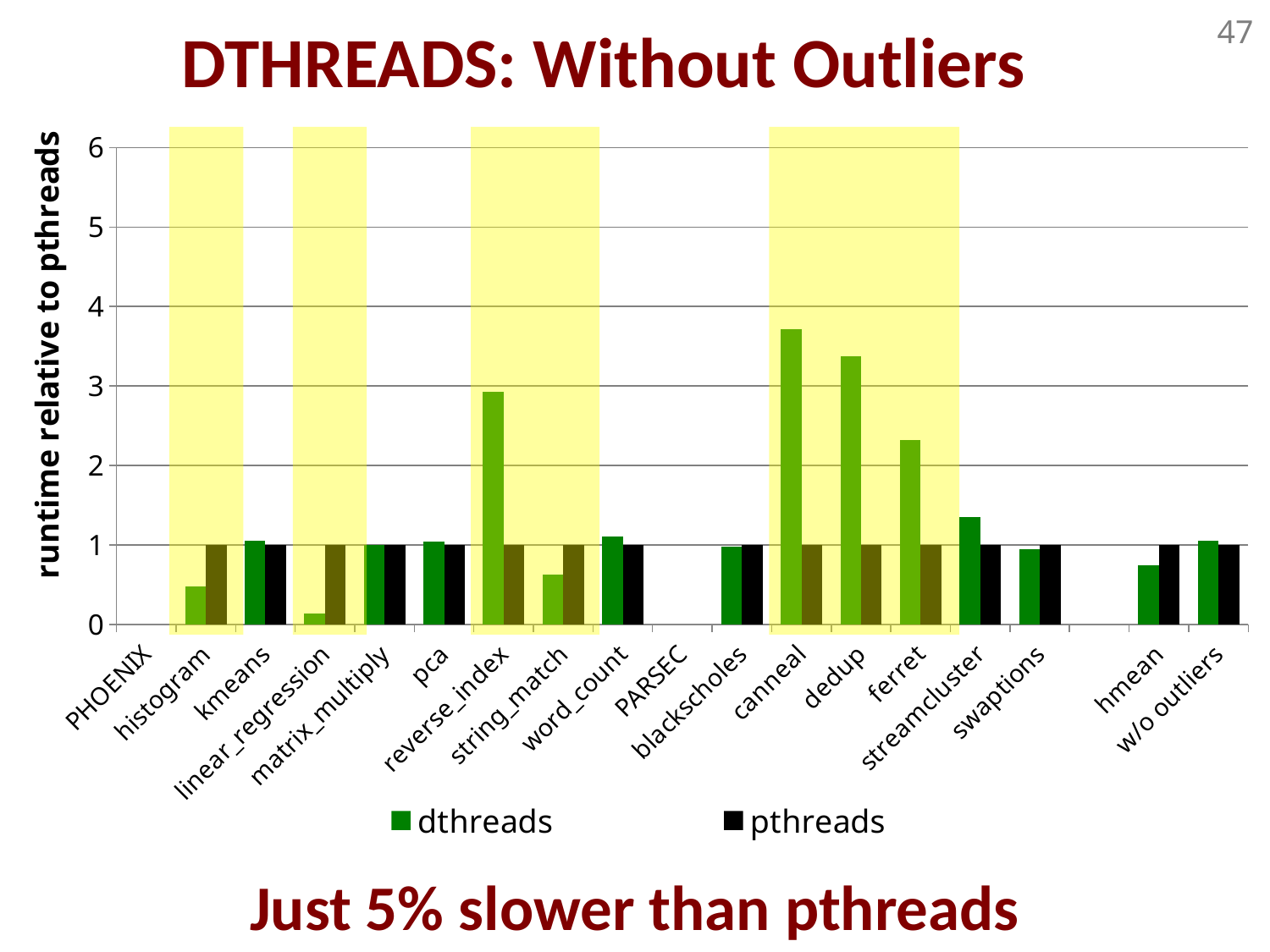
Is the dthreads value for histogram greater or less than 1? less Is the dthreads value for hmean greater or less than 1? less Which has the larger dthreads value, reverse_index or ferret? reverse_index Which has the larger dthreads value, canneal or dedup? canneal Which benchmark has the lowest dthreads value? linear_regression Is the dthreads value for ferret greater or less than 2? greater How many series does the legend list? 2 Which benchmark has the highest dthreads value? canneal What kind of chart is shown on the slide? bar chart What is the label of the vertical axis? runtime relative to pthreads Which series are listed in the legend? dthreads and pthreads